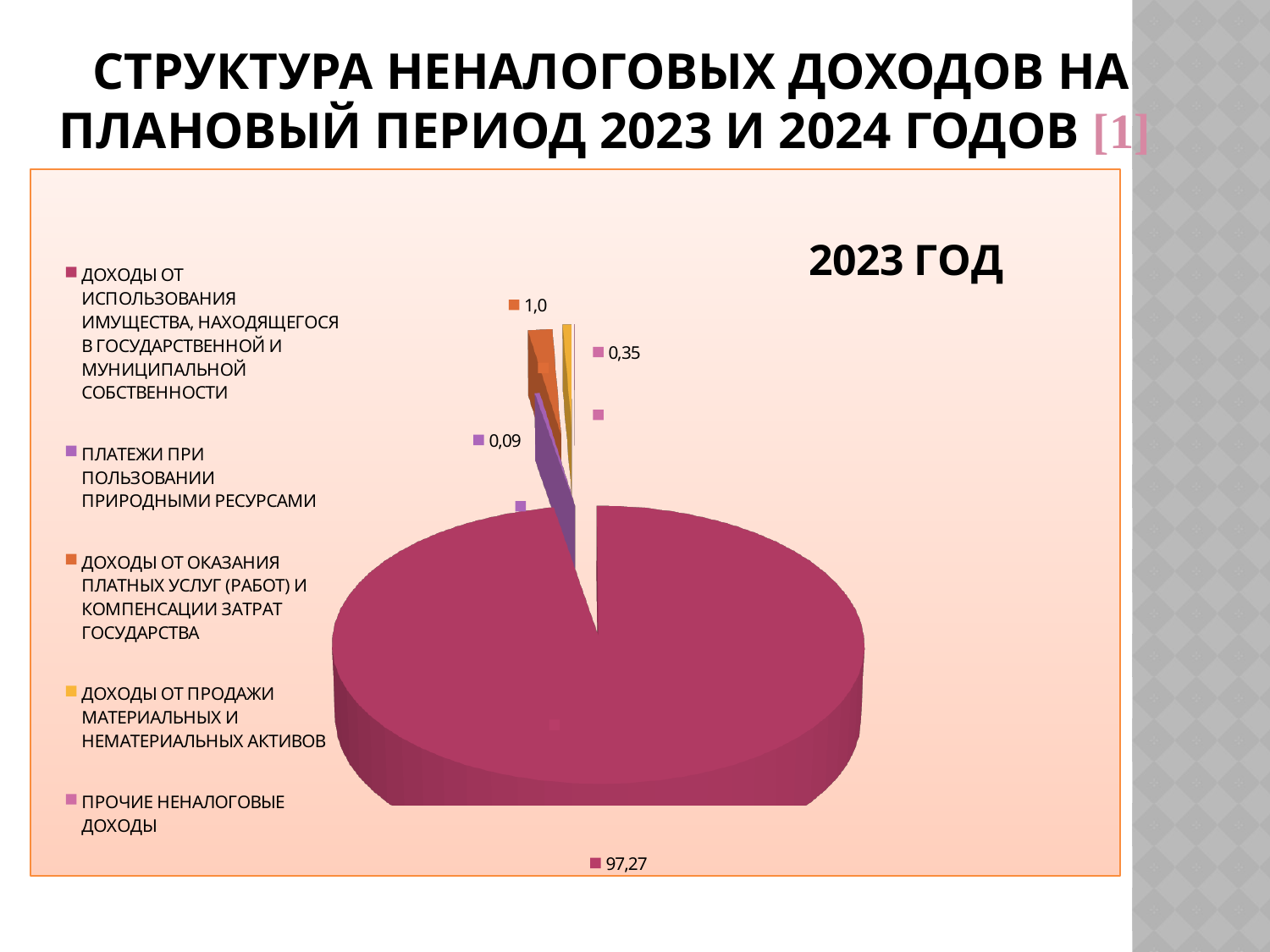
What value is shown for ДОХОДЫ ОТ ИСПОЛЬЗОВАНИЯ ИМУЩЕСТВА, НАХОДЯЩЕГОСЯ В ГОСУДАРСТВЕННОЙ И МУНИЦИПАЛЬНОЙ СОБСТВЕННОСТИ? 97,27 Which is larger: the slice labelled 1,0 or the slice labelled 0,35? 1,0 Which category has the largest share of the pie? ДОХОДЫ ОТ ИСПОЛЬЗОВАНИЯ ИМУЩЕСТВА, НАХОДЯЩЕГОСЯ В ГОСУДАРСТВЕННОЙ И МУНИЦИПАЛЬНОЙ СОБСТВЕННОСТИ What type of chart is shown on the slide? Pie chart What colour is the largest slice of the pie? Magenta (dark pink) Which is larger: the value for ДОХОДЫ ОТ ИСПОЛЬЗОВАНИЯ ИМУЩЕСТВА or the value for ДОХОДЫ ОТ ОКАЗАНИЯ ПЛАТНЫХ УСЛУГ? ДОХОДЫ ОТ ИСПОЛЬЗОВАНИЯ ИМУЩЕСТВА How many categories does the chart legend list? 5 What value is shown for ДОХОДЫ ОТ ОКАЗАНИЯ ПЛАТНЫХ УСЛУГ (РАБОТ) И КОМПЕНСАЦИИ ЗАТРАТ ГОСУДАРСТВА? 1,0 What is the smallest value printed as a data label on the chart? 0,09 What is the difference between the value for ДОХОДЫ ОТ ИСПОЛЬЗОВАНИЯ ИМУЩЕСТВА (97,27) and the value for ДОХОДЫ ОТ ОКАЗАНИЯ ПЛАТНЫХ УСЛУГ (1,0)? 96,27 What is the title shown on the chart? 2023 ГОД